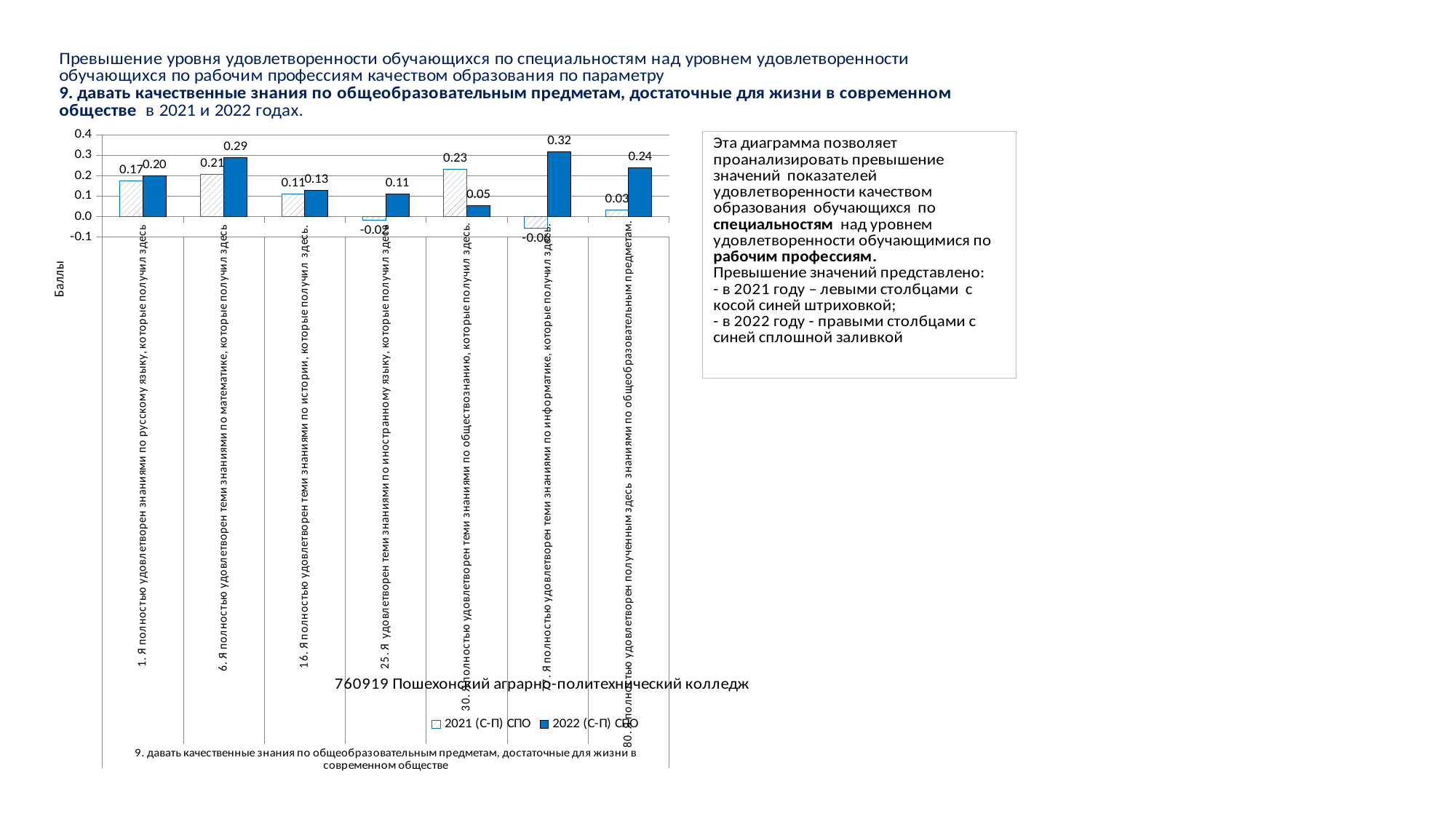
How many series does the legend list? 2 What is the 2022 (С-П) СПО value for the category about knowledge of mathematics (математике)? 0.29 What type of chart is shown on the slide? bar chart What is the 2021 (С-П) СПО value for the category about knowledge of social studies (обществознанию)? 0.23 How many categories are plotted on the x axis? 7 What is the 2021 (С-П) СПО value for the category about knowledge of informatics (информатике)? -0.06 Which series is shown with solid blue fill according to the legend? 2022 (С-П) СПО For the category about knowledge of social studies (обществознанию), which is larger: the 2021 value or the 2022 value? 2021 Which category has the lowest 2021 (С-П) СПО value? информатике (informatics) Which category has the highest 2022 (С-П) СПО value? информатике (informatics) What is the 2022 (С-П) СПО value for the category about knowledge of Russian language (русскому языку)? 0.20 What is the difference between the 2022 and 2021 values for the category about knowledge of foreign language (иностранному языку)? 0.13